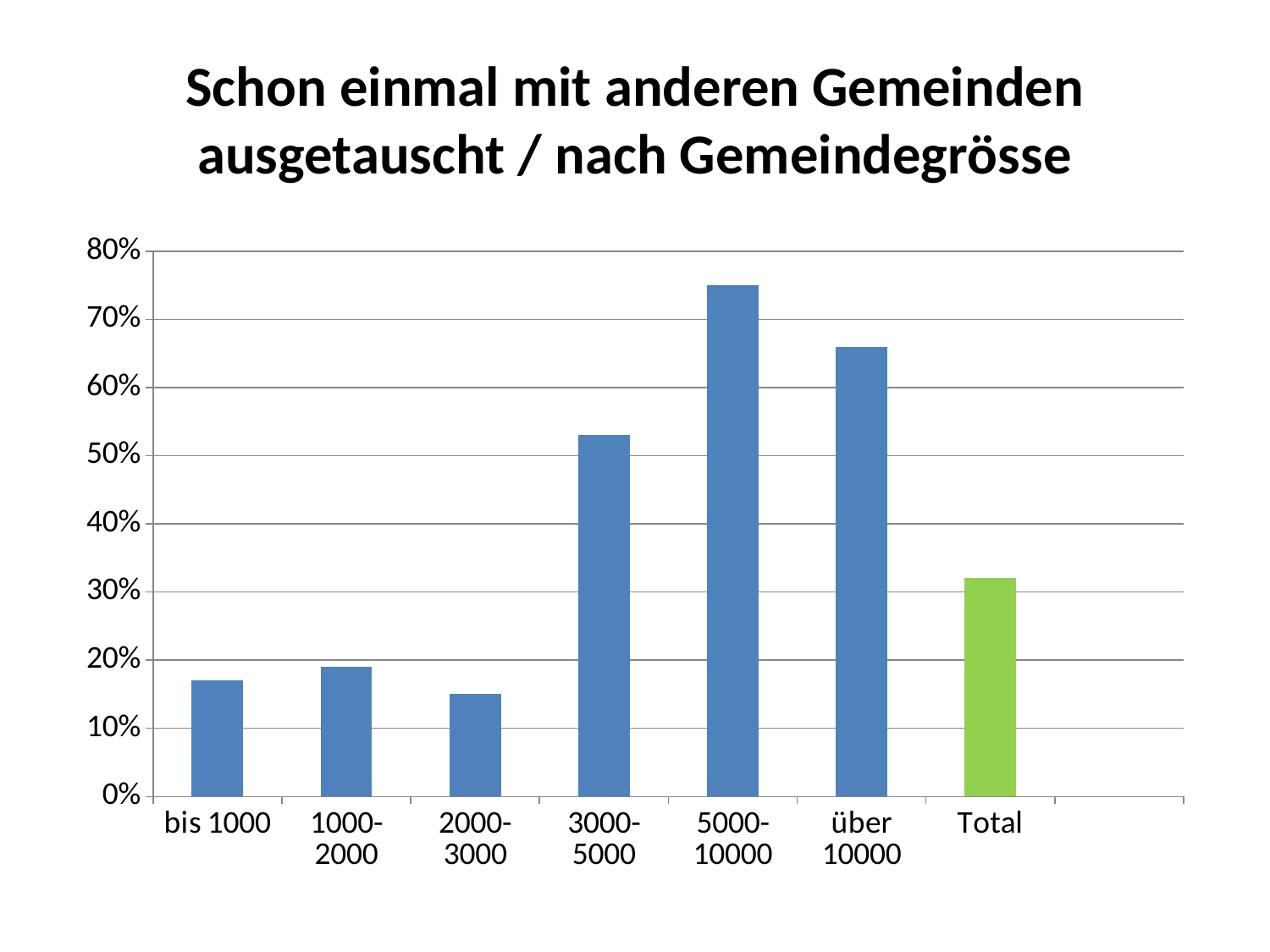
What colour is the bar for Total? green Is the value for Total greater or less than 30%? greater Is the value for 5000-10000 greater or less than 70%? greater Which category has the highest value in the chart? 5000-10000 Which category has the lowest value in the chart? 2000-3000 Is the value for 3000-5000 greater or less than 50%? greater How many categories are shown on the x axis of the chart? 7 What kind of chart is shown on the slide? bar chart Which is larger, the value for über 10000 or the value for 3000-5000? über 10000 What is the title of the chart? Schon einmal mit anderen Gemeinden ausgetauscht / nach Gemeindegrösse